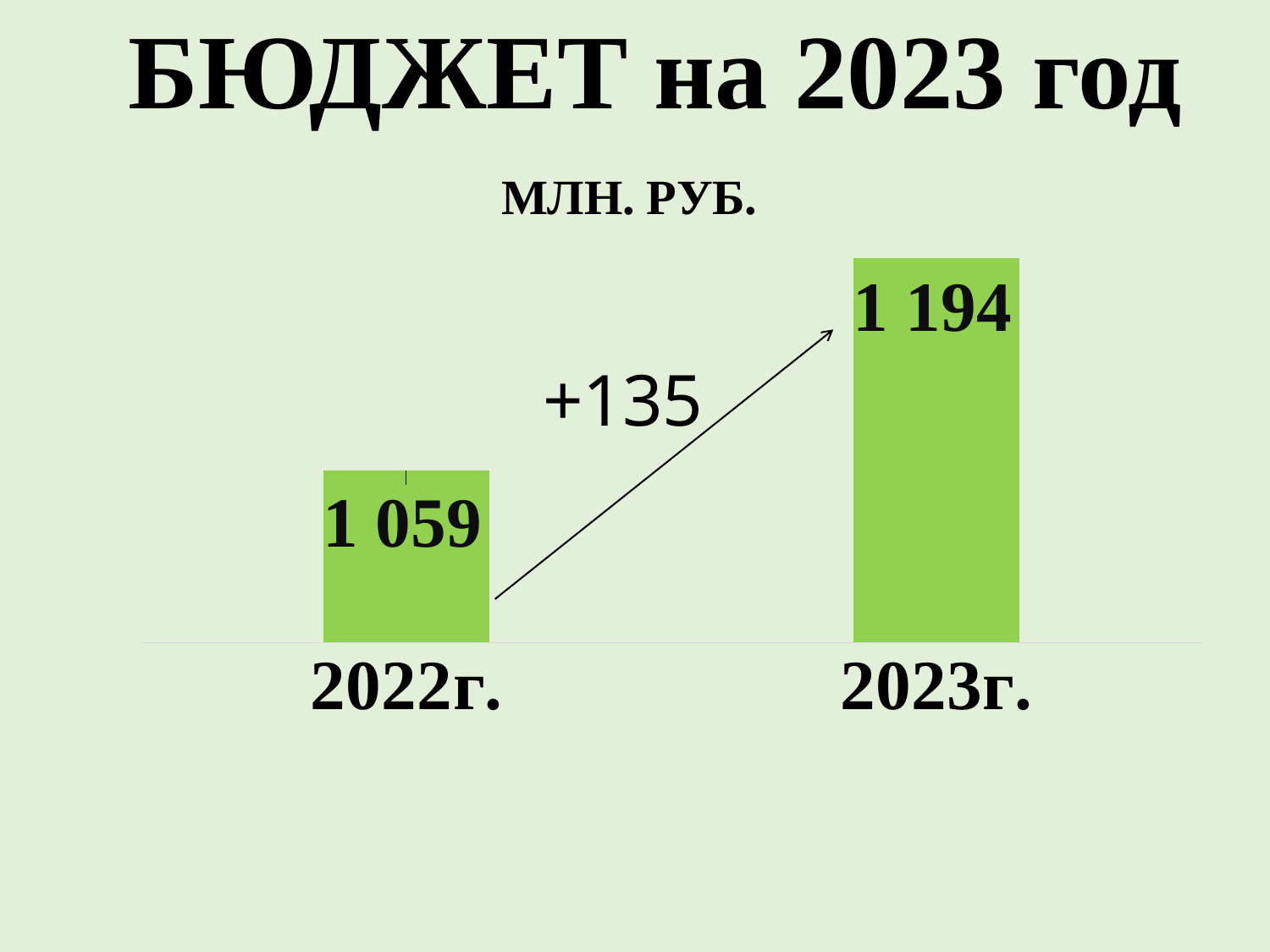
Which year has the lower value? 2022г. Is the value for 2023г. larger or smaller than the value for 2022г.? larger What is the value for 2022г.? 1 059 What unit is stated above the chart? МЛН. РУБ. What change is written next to the arrow between the two bars? +135 Which year has the higher value? 2023г. What is the title of the slide? БЮДЖЕТ на 2023 год What is the value for 2023г.? 1 194 How many bars are shown in the chart? 2 What kind of chart is shown on the slide? bar chart Do the values rise or fall from 2022г. to 2023г.? rise What is the difference between the values for 2023г. and 2022г.? 135